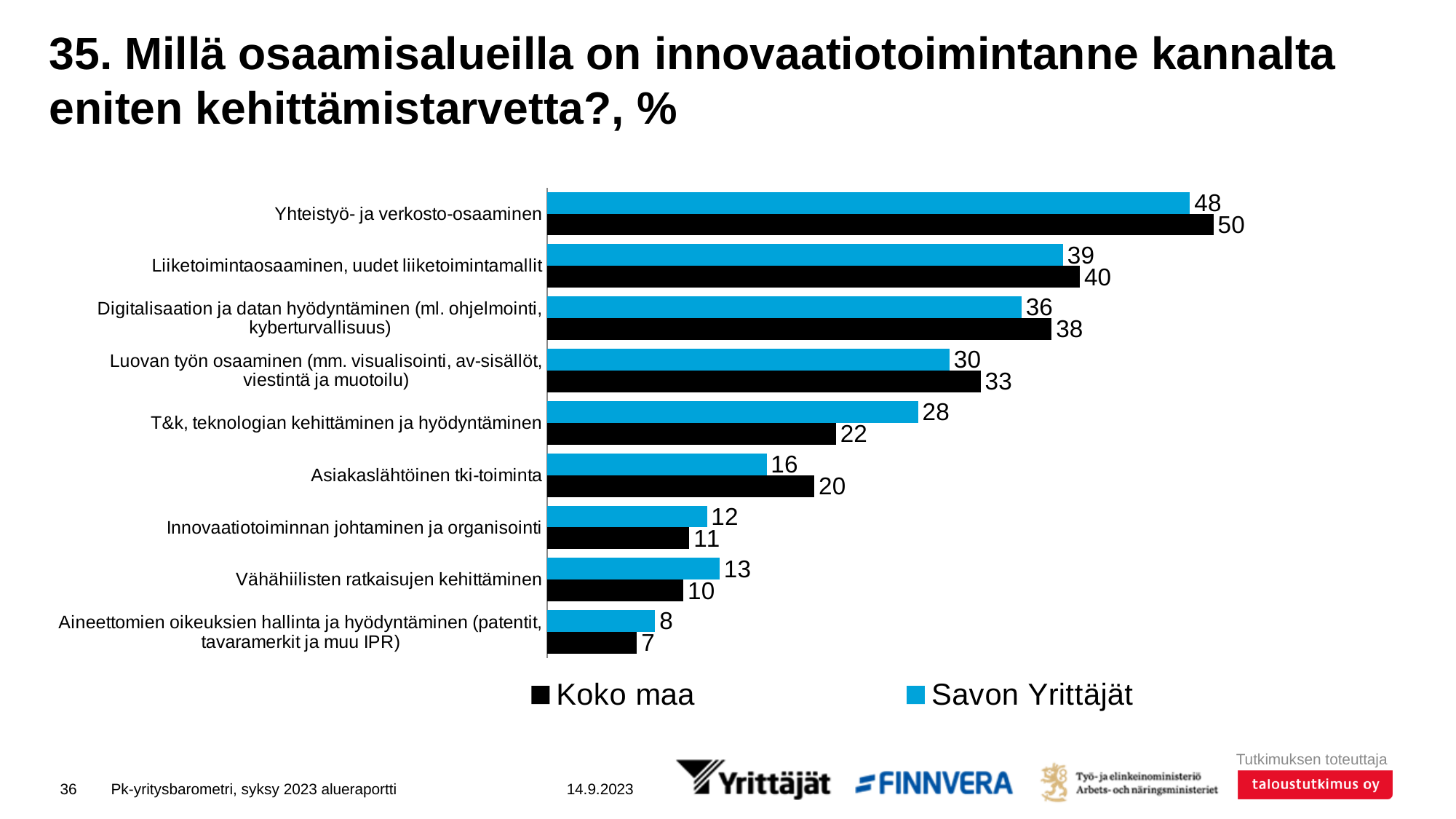
What kind of chart is shown on the slide? Bar chart What is the value for Savon Yrittäjät for T&k, teknologian kehittäminen ja hyödyntäminen? 28 How many categories are shown in the chart? 9 Which category has the lowest value for Koko maa? Aineettomien oikeuksien hallinta ja hyödyntäminen (patentit, tavaramerkit ja muu IPR) Which is larger for Vähähiilisten ratkaisujen kehittäminen, Koko maa or Savon Yrittäjät? Savon Yrittäjät Which is larger for Luovan työn osaaminen, Koko maa or Savon Yrittäjät? Koko maa What is the value for Koko maa for Yhteistyö- ja verkosto-osaaminen? 50 How many series does the legend list? 2 What is the difference between Koko maa and Savon Yrittäjät for T&k, teknologian kehittäminen ja hyödyntäminen? 6 Which colour represents Savon Yrittäjät in the chart? Blue What is the value for Savon Yrittäjät for Asiakaslähtöinen tki-toiminta? 16 Which category has the highest value for Savon Yrittäjät? Yhteistyö- ja verkosto-osaaminen